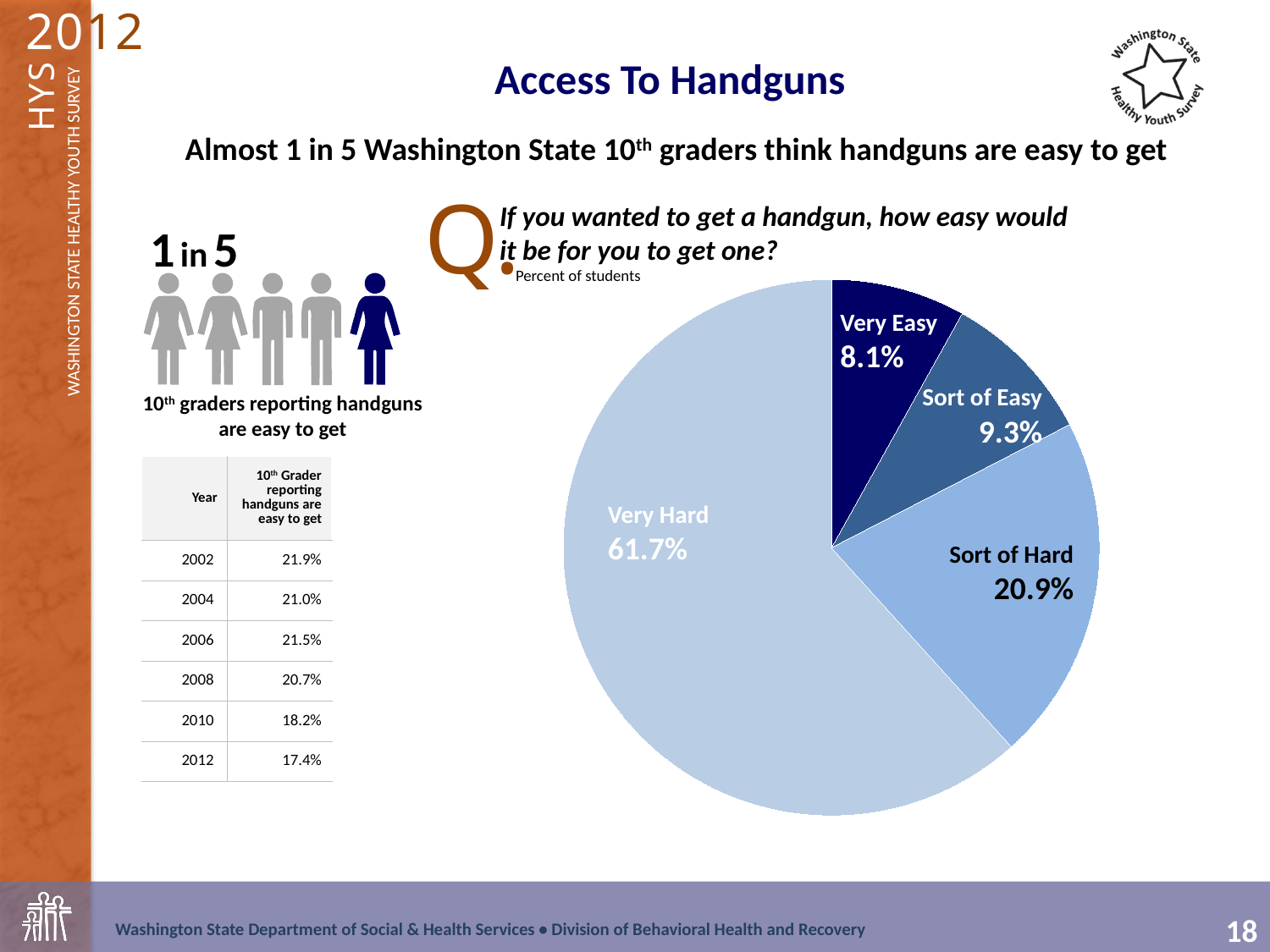
How many slices does the pie chart have? 4 Which is larger in the pie chart, "Sort of Easy" or "Sort of Hard"? Sort of Hard What kind of chart is shown on the slide? pie chart What survey question does the pie chart present responses to? If you wanted to get a handgun, how easy would it be for you to get one? What is the difference between the "Sort of Easy" and "Very Easy" percentages in the pie chart? 1.2% What percentage of students answered "Very Hard" in the pie chart? 61.7% What percentage of students answered "Sort of Easy" in the pie chart? 9.3% Which slice of the pie chart is the smallest? Very Easy Which slice of the pie chart is the largest? Very Hard What is the difference between the "Very Hard" and "Sort of Hard" percentages in the pie chart? 40.8% What percentage of students answered "Very Easy" in the pie chart? 8.1% What percentage of students answered "Sort of Hard" in the pie chart? 20.9%